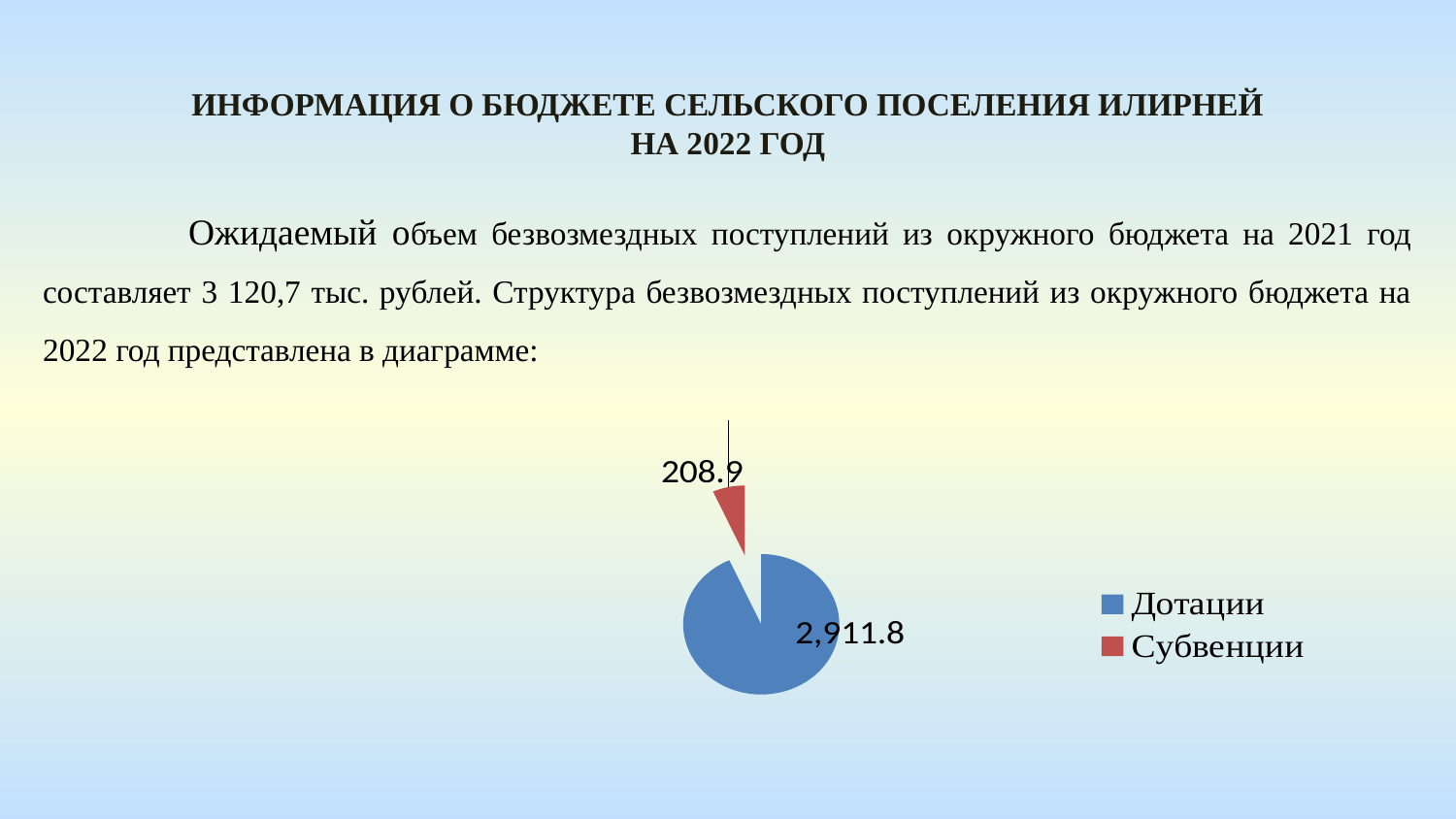
Which category has the largest slice in the pie chart? Дотации What is the value of the Субвенции slice in the pie chart? 208.9 What is the total of the two slices shown in the pie chart? 3,120.7 What kind of chart is shown on the slide? Pie chart How many slices does the pie chart have? 2 What is the value of the Дотации slice in the pie chart? 2,911.8 How many entries does the legend of the pie chart list? 2 Which is larger in the pie chart, Дотации or Субвенции? Дотации What is the difference between the Дотации value and the Субвенции value in the pie chart? 2,702.9 Which category has the smallest slice in the pie chart? Субвенции What colour is the Субвенции slice in the pie chart? Red What colour is the Дотации slice in the pie chart? Blue